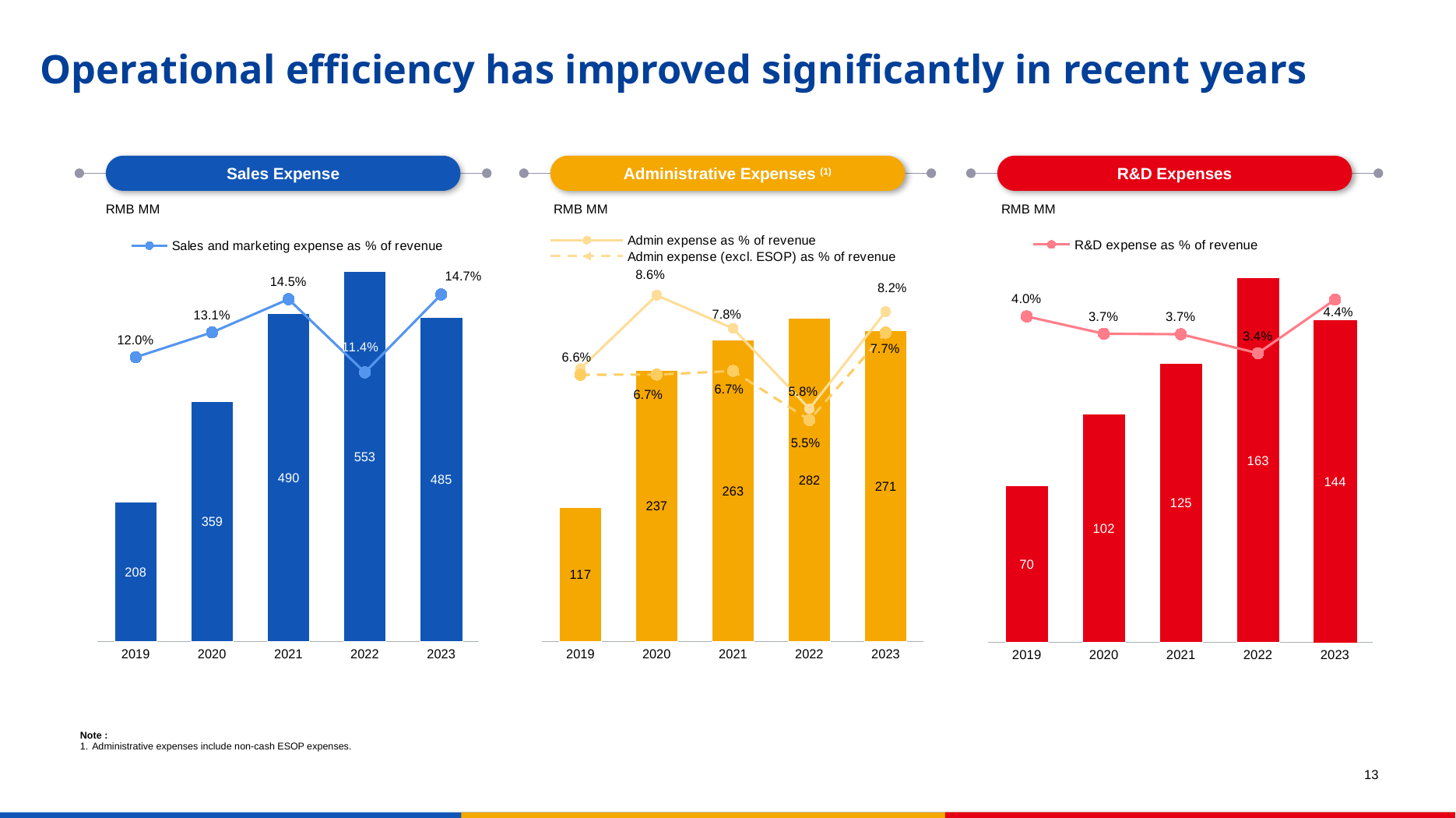
How many series does the legend of the Administrative Expenses chart list? 2 In the Administrative Expenses chart, what was the administrative expense in RMB MM in 2021? 263 In the R&D Expenses chart, is the R&D expense in 2021 larger or smaller than in 2023? smaller In the Administrative Expenses chart, which year had the highest administrative expense? 2022 In the R&D Expenses chart, what was the R&D expense in RMB MM in 2020? 102 In the Sales Expense chart, what was the sales expense in RMB MM in 2022? 553 In the R&D Expenses chart, which year had the highest R&D expense? 2022 In the Sales Expense chart, what was sales and marketing expense as % of revenue in 2023? 14.7% In the Administrative Expenses chart, what was admin expense (excl. ESOP) as % of revenue in 2023? 7.7% In the Sales Expense chart, what is the difference between the sales expense in 2022 and 2023? 68 In the Sales Expense chart, which year had the lowest sales expense? 2019 How many years are shown on the x axis of the R&D Expenses chart? 5